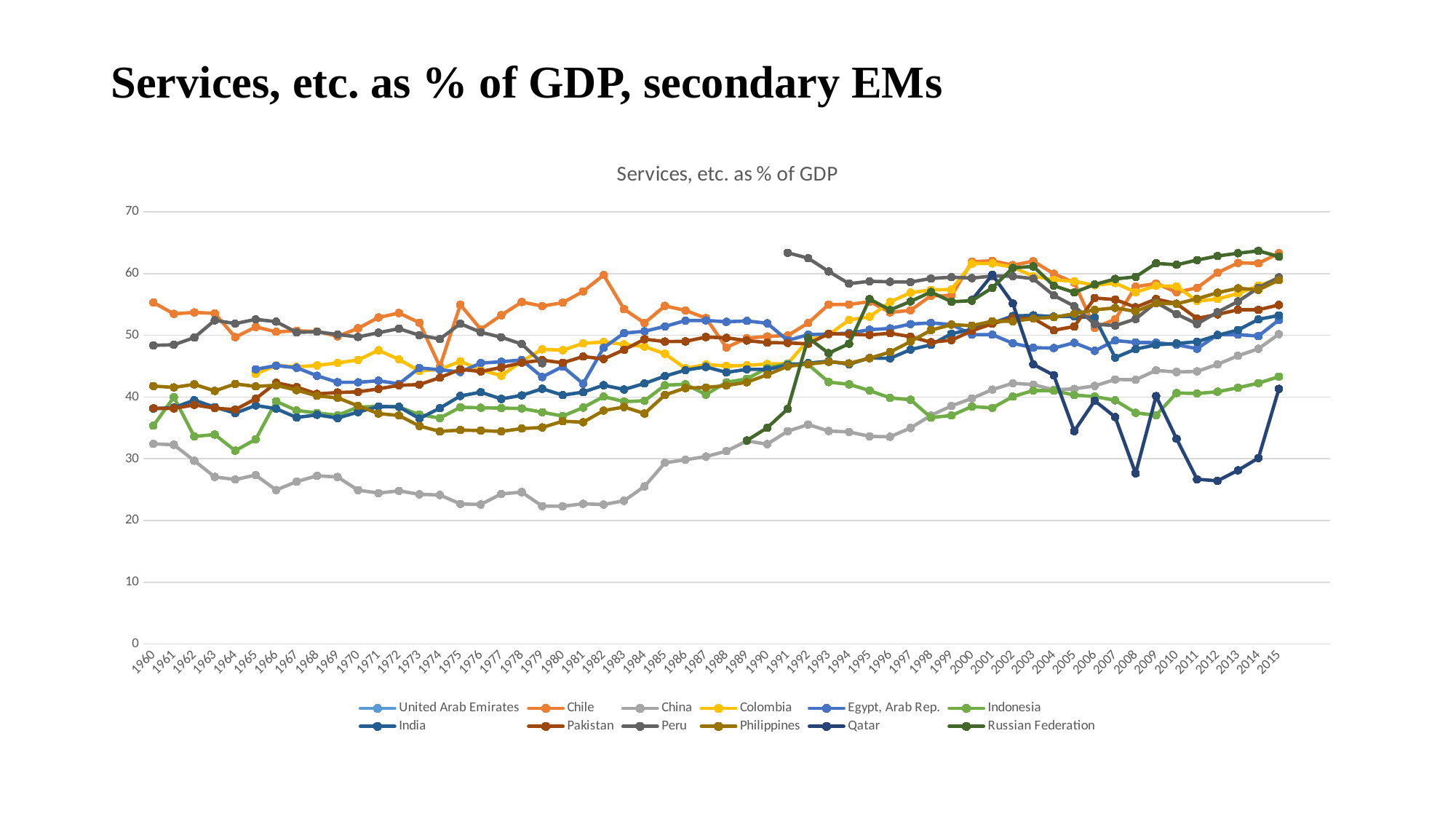
Is the value for China in 1960 greater or less than 40? less Is the value for Qatar in 2011 greater or less than 30? less Does the value for China rise or fall overall from 1960 to 2015? rise What kind of chart is shown on the slide? line chart What is the title shown above the plot area? Services, etc. as % of GDP Which series has the highest value in 1960? Chile In 2015, which is larger: the value for Qatar or the value for Russian Federation? Russian Federation How many series does the legend list? 12 Is the value for Russian Federation in 2015 greater or less than 60? greater How many years are plotted along the x axis? 56